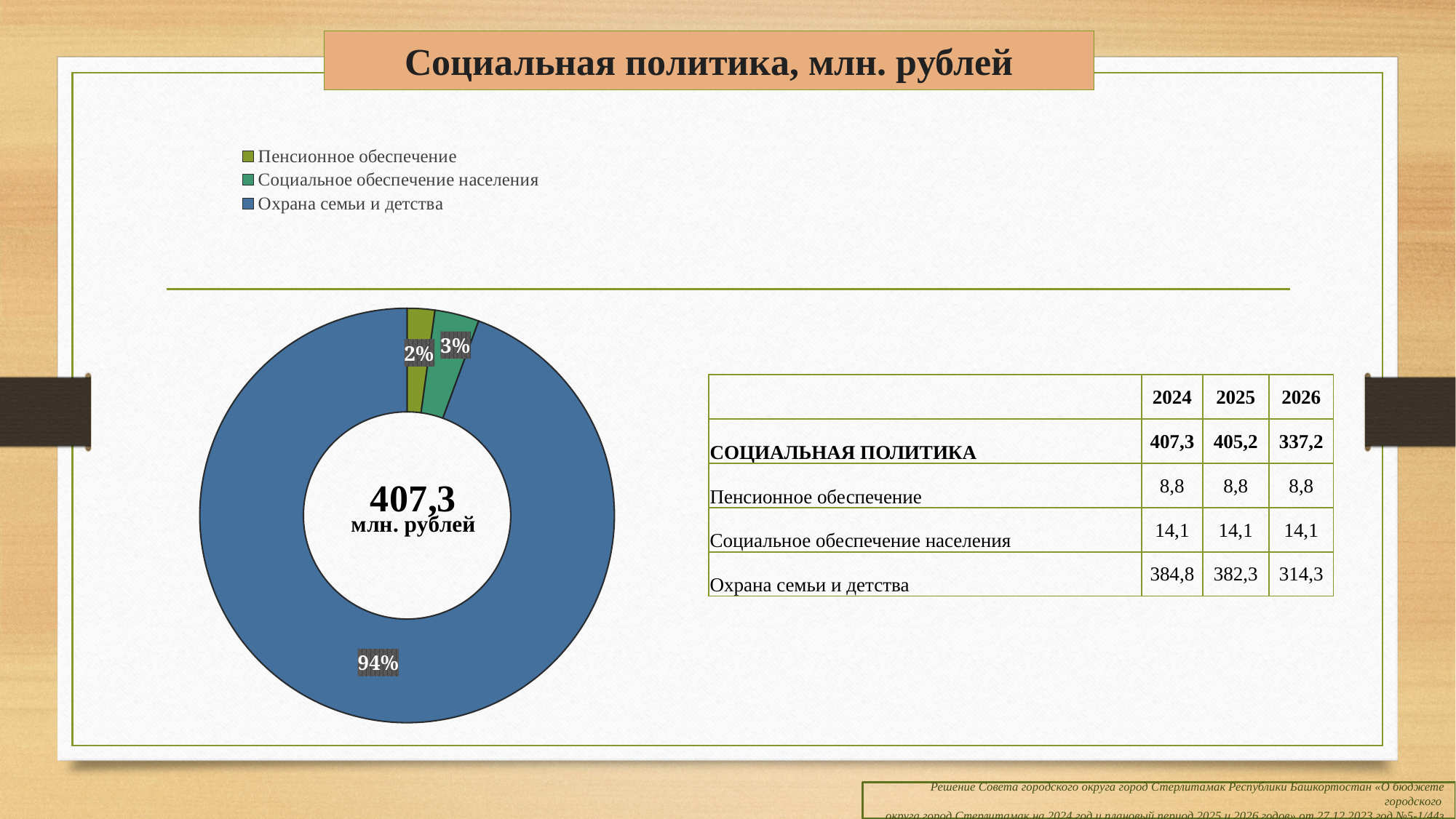
Which slice is larger: Социальное обеспечение населения or Пенсионное обеспечение? Социальное обеспечение населения What is the title of the slide containing the doughnut chart? Социальная политика, млн. рублей What share of the doughnut chart does Охрана семьи и детства take? 94% Which category has the smallest slice in the doughnut chart? Пенсионное обеспечение What share of the doughnut chart does Пенсионное обеспечение take? 2% What total value is printed in the centre of the doughnut chart? 407,3 млн. рублей How many categories does the doughnut chart show? 3 What is the difference in percentage points between the Охрана семьи и детства slice and the Социальное обеспечение населения slice? 91 percentage points Which colour represents Охрана семьи и детства in the doughnut chart? Blue What kind of chart is shown on the slide? Doughnut (pie) chart Which category has the largest slice in the doughnut chart? Охрана семьи и детства What share of the doughnut chart does Социальное обеспечение населения take? 3%